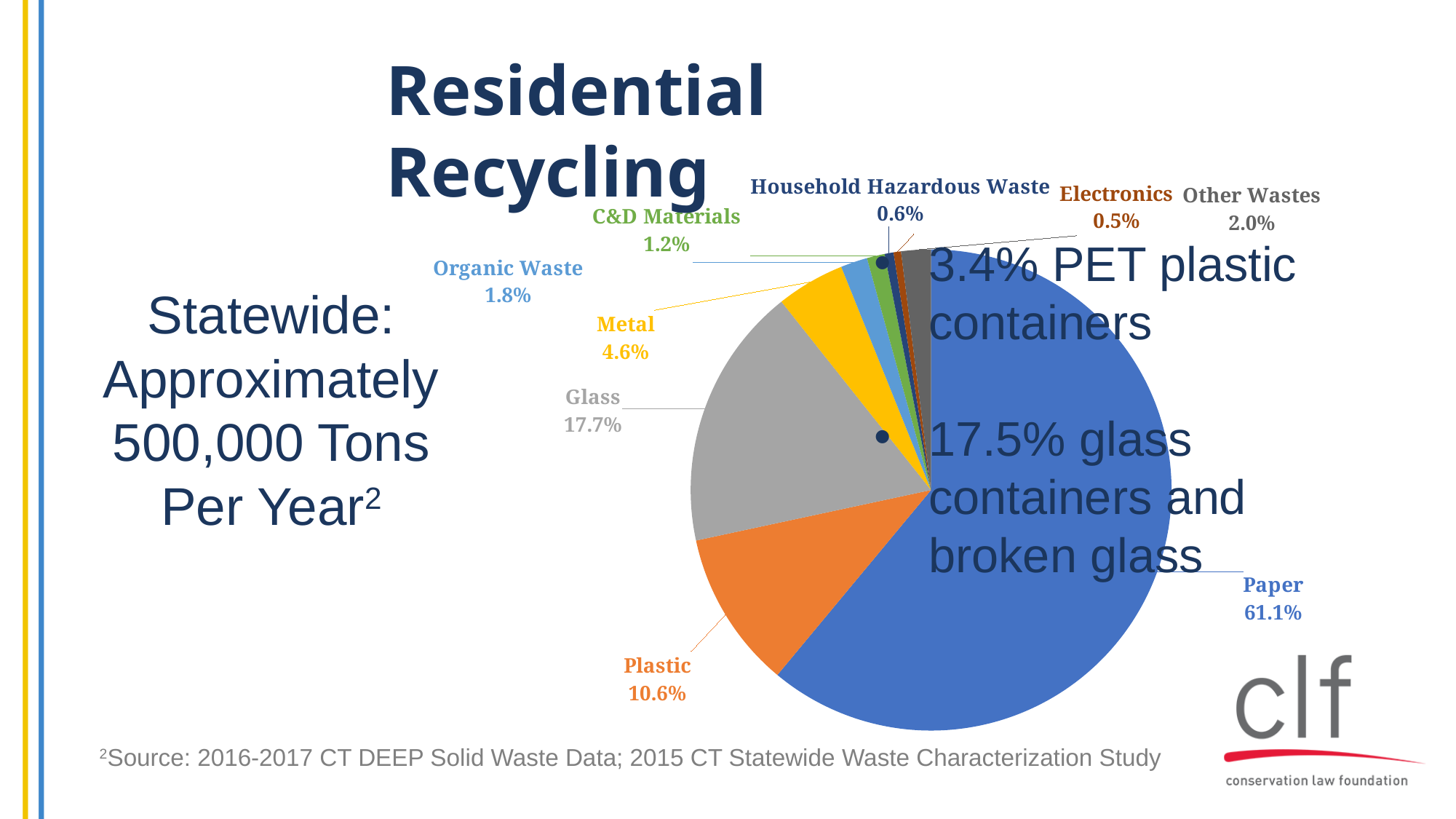
What kind of chart is shown on the slide? pie chart Which is larger, the share for Organic Waste or the share for C&D Materials? Organic Waste What is the value shown for Plastic? 10.6% What is the value shown for Metal? 4.6% How many categories are shown in the pie chart? 9 Which category has the smallest slice of the pie? Electronics What is the value shown for Glass? 17.7% Which category has the largest slice of the pie? Paper What is the value shown for Household Hazardous Waste? 0.6% What share of the pie does Paper account for? 61.1% What is the title of the slide containing the pie chart? Residential Recycling What is the difference between the Glass and Plastic shares? 7.1%